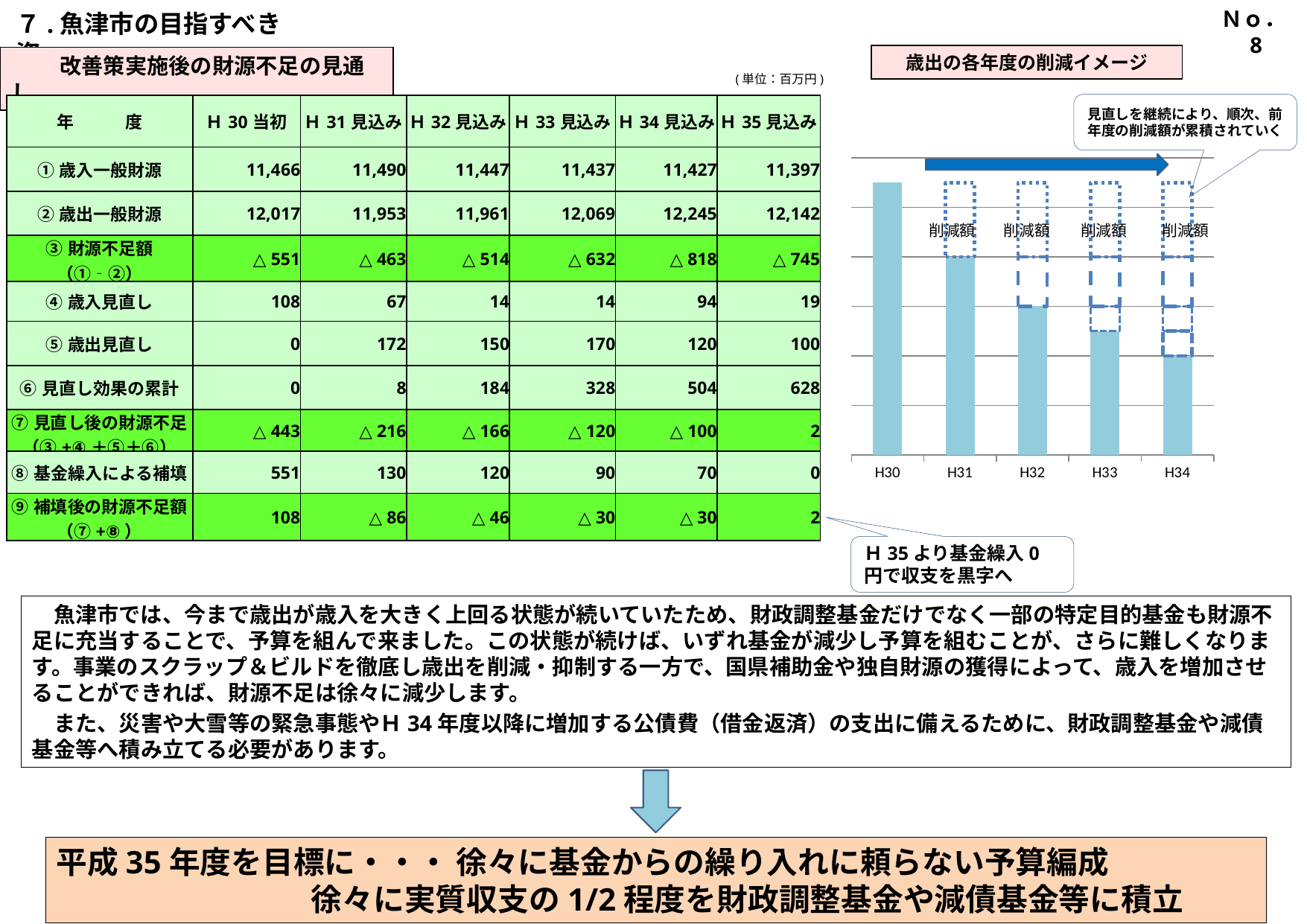
In the 歳出の各年度の削減イメージ chart, is the solid bar for H31 taller or shorter than the solid bar for H33? taller How many fiscal years are shown on the x axis of the 歳出の各年度の削減イメージ chart? 5 In the 歳出の各年度の削減イメージ chart, which year has the tallest solid bar? H30 In the 歳出の各年度の削減イメージ chart, do the solid bars rise or fall from H30 to H34? fall In the 歳出の各年度の削減イメージ chart, which solid bar is taller, H32 or H34? H32 What label is written inside the dotted boxes above the bars in the 歳出の各年度の削減イメージ chart? 削減額 What is the first year label on the x axis of the 歳出の各年度の削減イメージ chart? H30 In the 歳出の各年度の削減イメージ chart, which year has the shortest solid bar? H34 What kind of chart is shown under the title 歳出の各年度の削減イメージ? bar chart